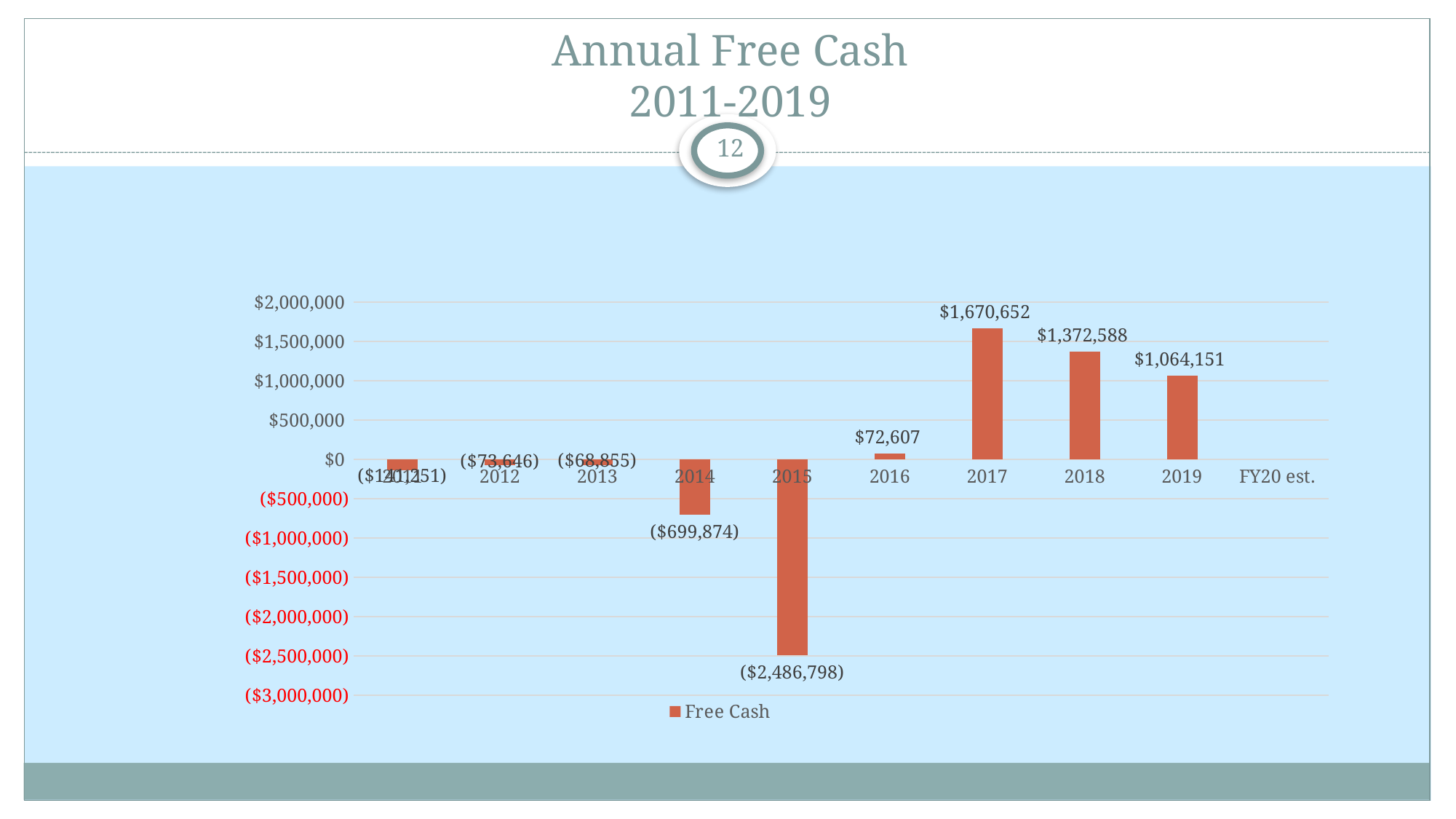
Which year has the larger Free Cash value, 2018 or 2019? 2018 How many series does the legend list? 1 Is the Free Cash value for 2011 greater or less than ($500,000)? greater Which year has the highest Free Cash value? 2017 What is the Free Cash value for 2017? $1,670,652 Do the Free Cash values rise or fall from 2017 to 2019? Fall What is the Free Cash value for 2016? $72,607 What is the Free Cash value for 2014? ($699,874) What kind of chart is shown on the slide? Bar chart What is the difference between the Free Cash values for 2017 and 2018? $298,064 What is the Free Cash value for 2015? ($2,486,798) Which year has the lowest Free Cash value? 2015